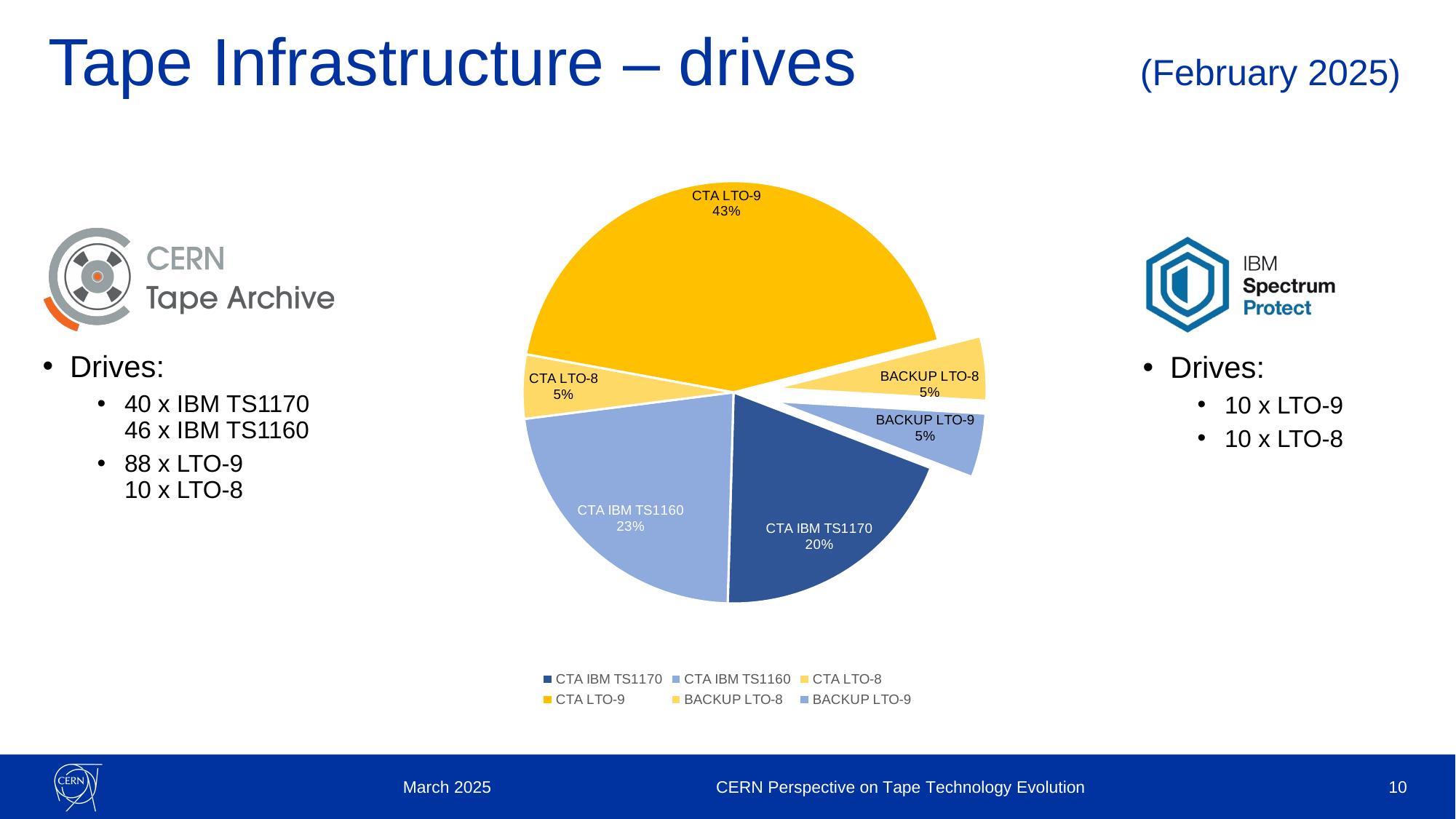
What is the combined share of the CTA LTO-8, BACKUP LTO-8 and BACKUP LTO-9 slices? 15% What is the difference in percentage points between the CTA LTO-9 slice and the CTA IBM TS1170 slice? 23 What kind of chart is shown on the slide? pie chart What colour is the CTA IBM TS1170 slice in the pie chart? dark blue What share of the pie does CTA IBM TS1170 have? 20% What share of the pie does CTA LTO-9 have? 43% What share of the pie does BACKUP LTO-9 have? 5% How many entries does the legend list? 6 Which is larger, the CTA IBM TS1160 slice or the CTA IBM TS1170 slice? CTA IBM TS1160 Which slice of the pie is the largest? CTA LTO-9 How many slices does the pie chart have? 6